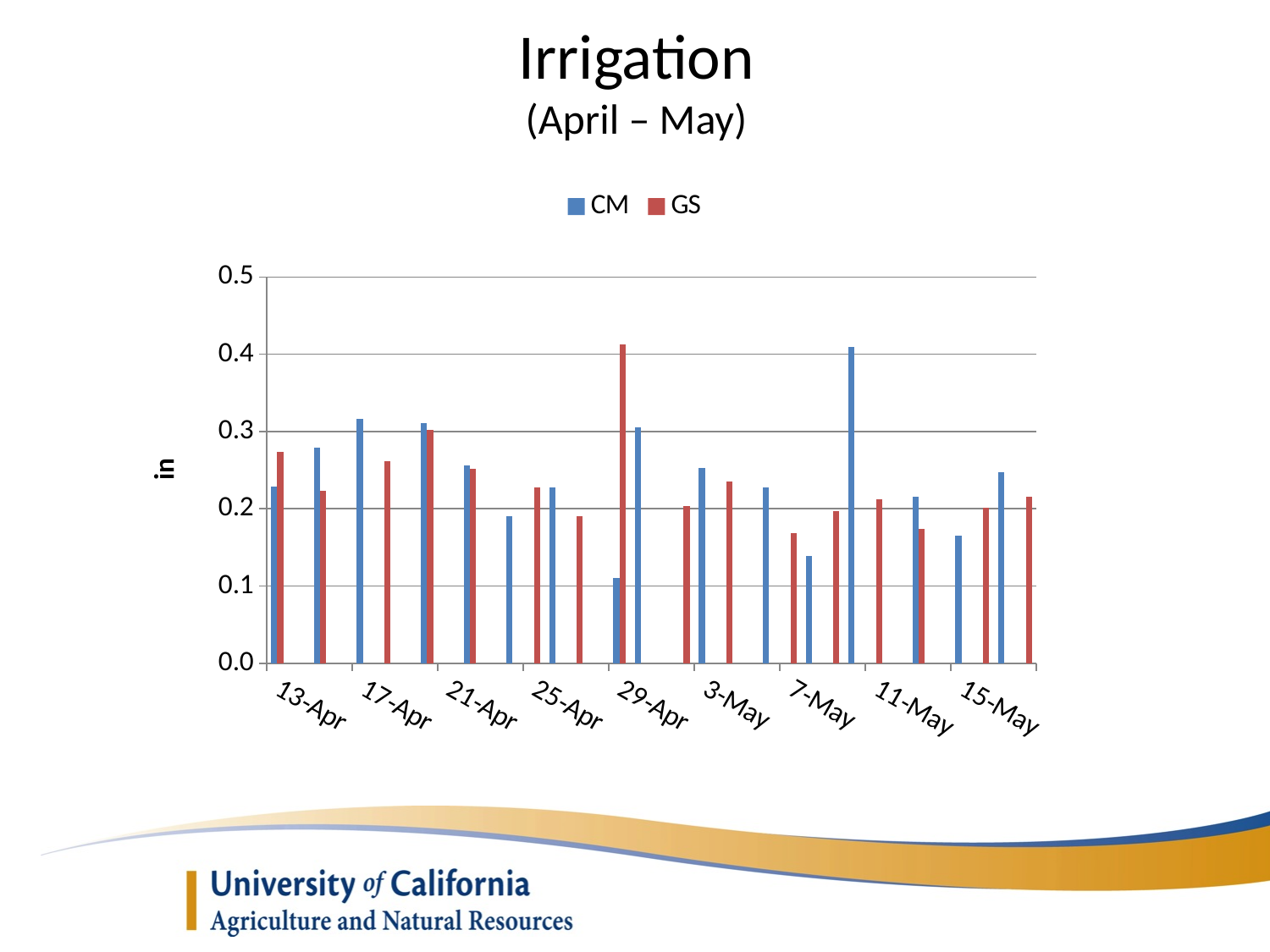
Is the tallest GS bar greater or less than 0.4? greater Is the first GS bar on the left (at 13-Apr) greater or less than 0.2? greater What kind of chart is shown on the slide? bar chart Is the shortest CM bar greater or less than 0.2? less How many series does the legend list? 2 What is the label on the y axis? in How many date labels are shown along the x axis? 9 What are the names of the two series in the legend? CM and GS